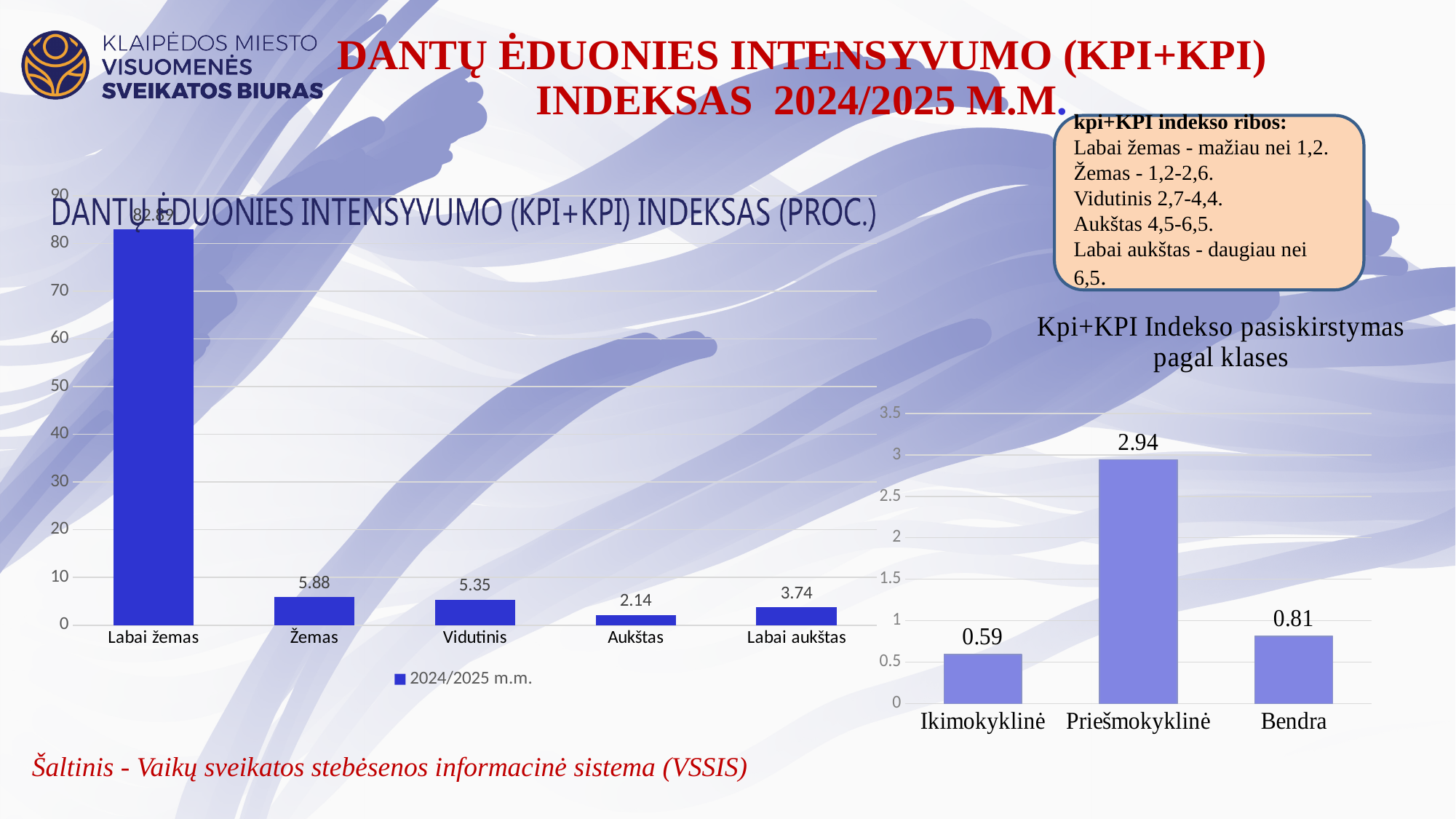
In the chart 'DANTŲ ĖDUONIES INTENSYVUMO (KPI+KPI) INDEKSAS (PROC.)', how many categories are shown? 5 In the chart 'DANTŲ ĖDUONIES INTENSYVUMO (KPI+KPI) INDEKSAS (PROC.)', what is the value for Žemas? 5.88 In the chart 'Kpi+KPI Indekso pasiskirstymas pagal klases', what is the value for Priešmokyklinė? 2.94 What type of chart is 'Kpi+KPI Indekso pasiskirstymas pagal klases'? bar chart In the chart 'Kpi+KPI Indekso pasiskirstymas pagal klases', what is the difference between the values for Priešmokyklinė and Bendra? 2.13 In the chart 'DANTŲ ĖDUONIES INTENSYVUMO (KPI+KPI) INDEKSAS (PROC.)', what series does the legend list? 2024/2025 m.m. In the chart 'DANTŲ ĖDUONIES INTENSYVUMO (KPI+KPI) INDEKSAS (PROC.)', what is the value for Aukštas? 2.14 In the chart 'Kpi+KPI Indekso pasiskirstymas pagal klases', which category has the lowest value? Ikimokyklinė In the chart 'DANTŲ ĖDUONIES INTENSYVUMO (KPI+KPI) INDEKSAS (PROC.)', is the value for Labai žemas greater or less than 80? greater In the chart 'DANTŲ ĖDUONIES INTENSYVUMO (KPI+KPI) INDEKSAS (PROC.)', what is the difference between the values for Vidutinis and Labai aukštas? 1.61 In the chart 'DANTŲ ĖDUONIES INTENSYVUMO (KPI+KPI) INDEKSAS (PROC.)', which category has the lowest value? Aukštas In the chart 'DANTŲ ĖDUONIES INTENSYVUMO (KPI+KPI) INDEKSAS (PROC.)', which category has the highest value? Labai žemas